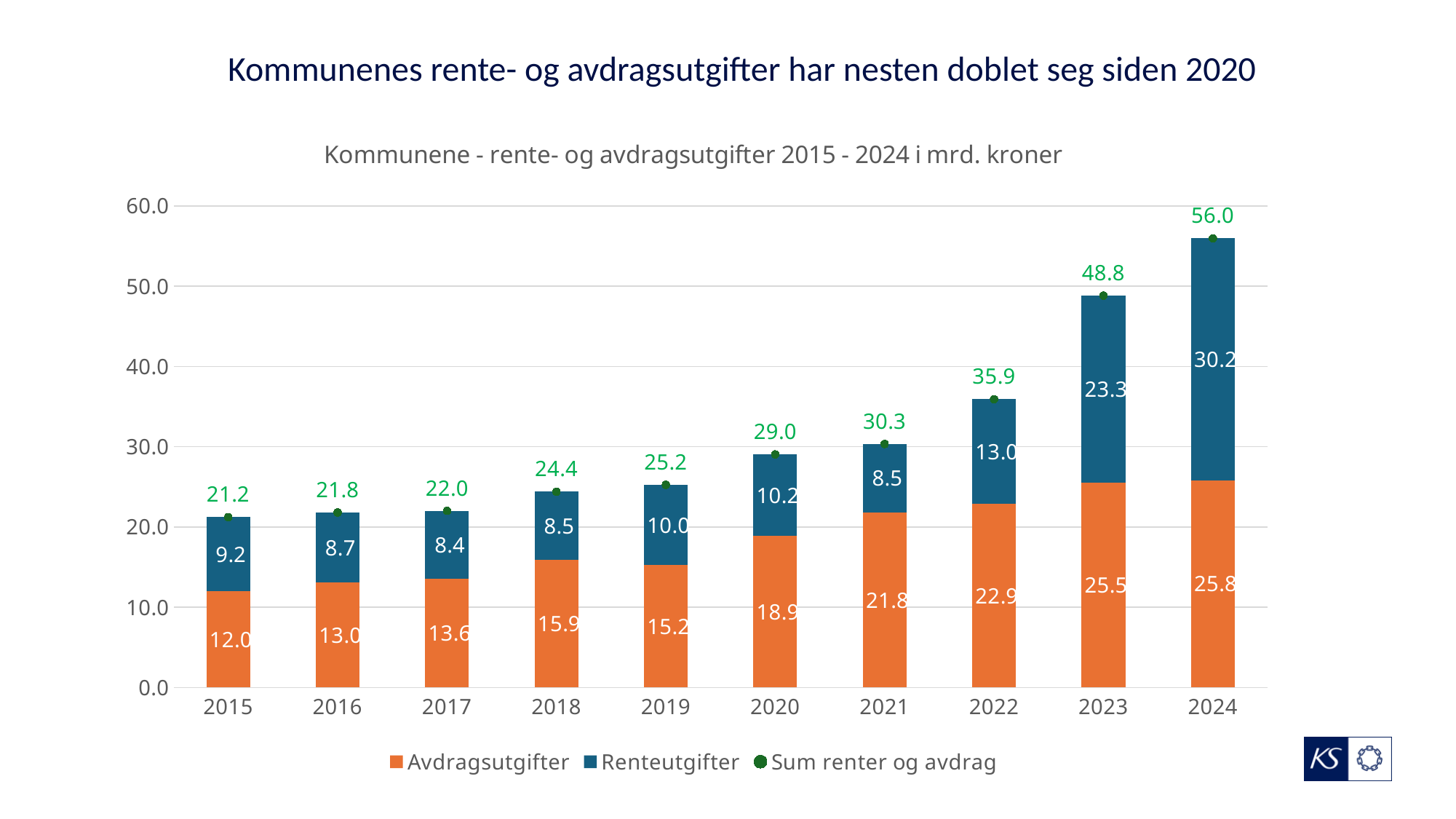
How many years are shown on the x axis? 10 Which year has the lowest Avdragsutgifter? 2015 How many series does the legend list? 3 Which is larger, Renteutgifter in 2019 or Renteutgifter in 2021? 2019 What is the total of the stacked bar for 2017? 22.0 What is the Sum renter og avdrag for 2018? 24.4 What is the difference in Renteutgifter between 2024 and 2022? 17.2 What is the value of Avdragsutgifter for 2020? 18.9 Which year has the highest Sum renter og avdrag? 2024 Is the Sum renter og avdrag for 2022 greater or less than 30.0? greater What kind of chart is this? Stacked bar chart with a line/marker series What is the value of Renteutgifter for 2023? 23.3